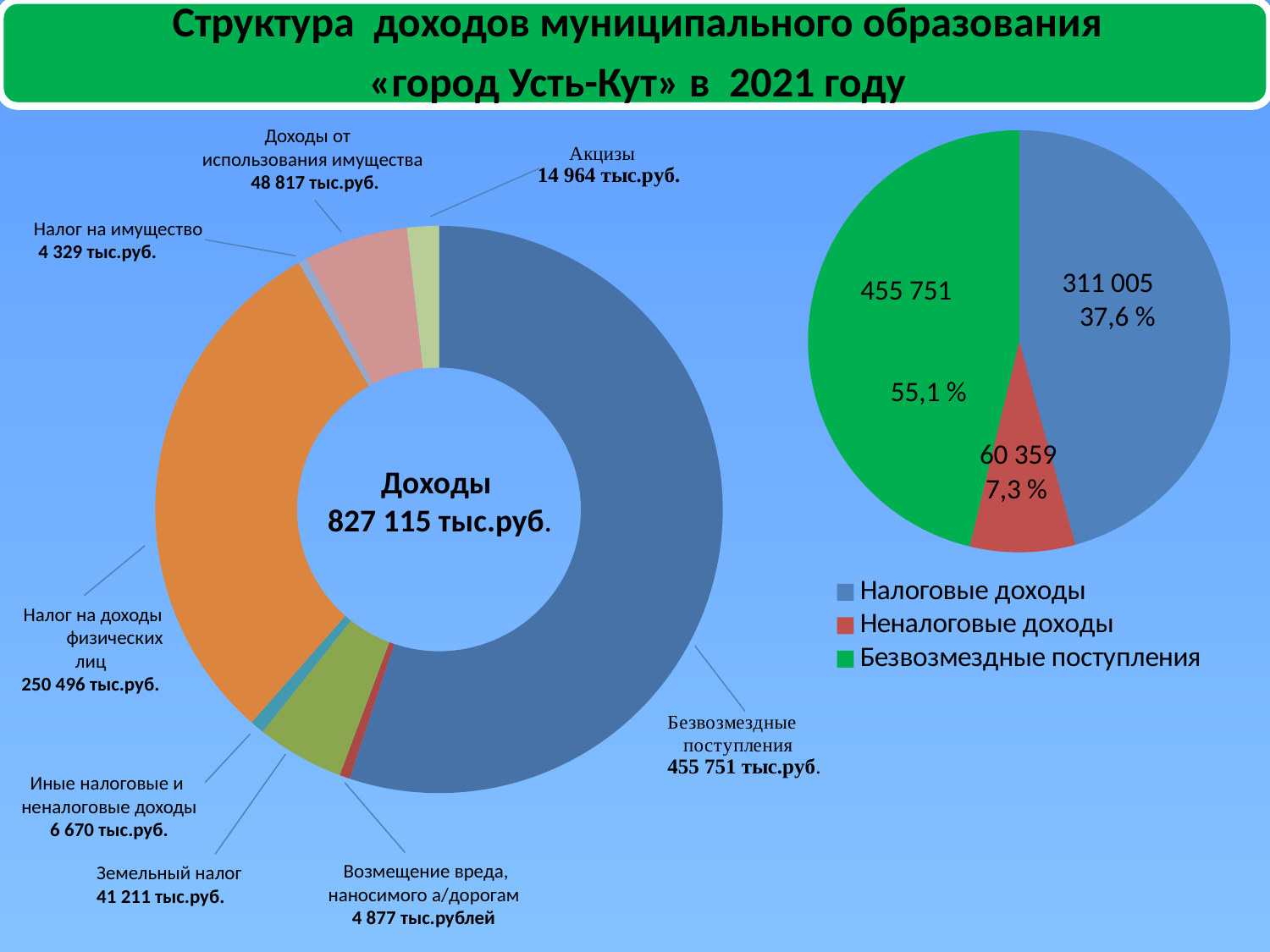
On the left doughnut chart, what is the value for Безвозмездные поступления? 455 751 тыс.руб. On the left doughnut chart, what is the value for Земельный налог? 41 211 тыс.руб. On the right pie chart, what share does Налоговые доходы have? 37,6 % What total is shown in the centre of the left doughnut chart? 827 115 тыс.руб. On the left doughnut chart, what is the difference between Доходы от использования имущества and Земельный налог? 7 606 тыс.руб. How many series does the legend of the right pie chart list? 3 How many categories does the left doughnut chart show? 8 On the left doughnut chart, which is larger: Иные налоговые и неналоговые доходы or Возмещение вреда, наносимого а/дорогам? Иные налоговые и неналоговые доходы On the left doughnut chart, which category has the smallest value? Налог на имущество On the left doughnut chart, what is the value for Акцизы? 14 964 тыс.руб. On the left doughnut chart, which category has the largest value? Безвозмездные поступления On the right pie chart, what is the value for Неналоговые доходы? 60 359